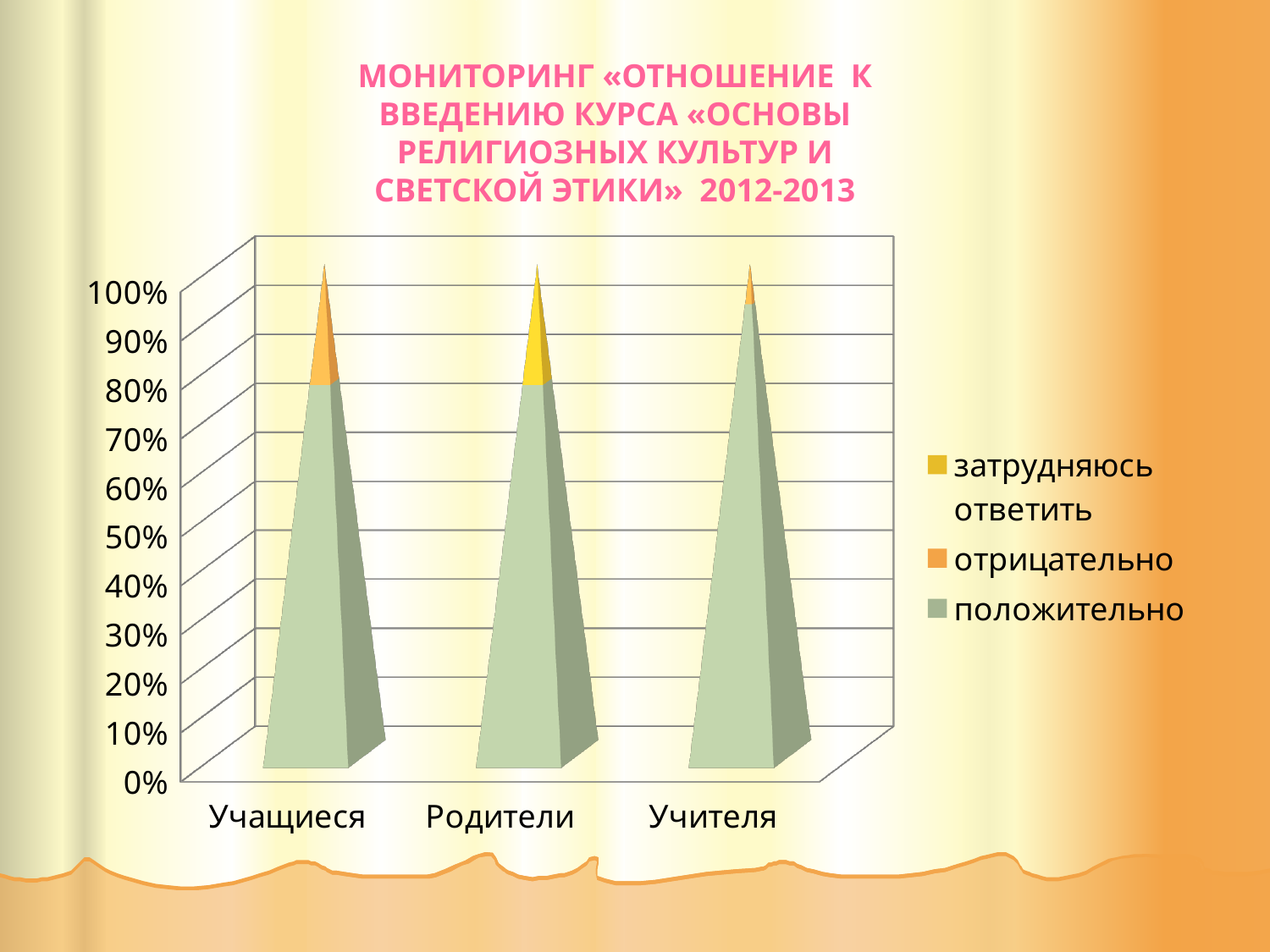
Which series is the largest for the Учащиеся category? положительно How many categories are shown on the x axis of the chart? 3 Is the value of положительно for Родители greater or less than 50%? greater What kind of chart is shown on the slide? bar chart How many series does the chart legend list? 3 Is the value of положительно for Учащиеся greater or less than 50%? greater Is the положительно share larger for Учителя or for Учащиеся? Учителя Which category has the largest положительно share? Учителя Is the value of отрицательно for Учащиеся greater or less than 30%? less Which series does the legend list last? положительно Which categories are shown on the x axis of the chart? Учащиеся, Родители, Учителя